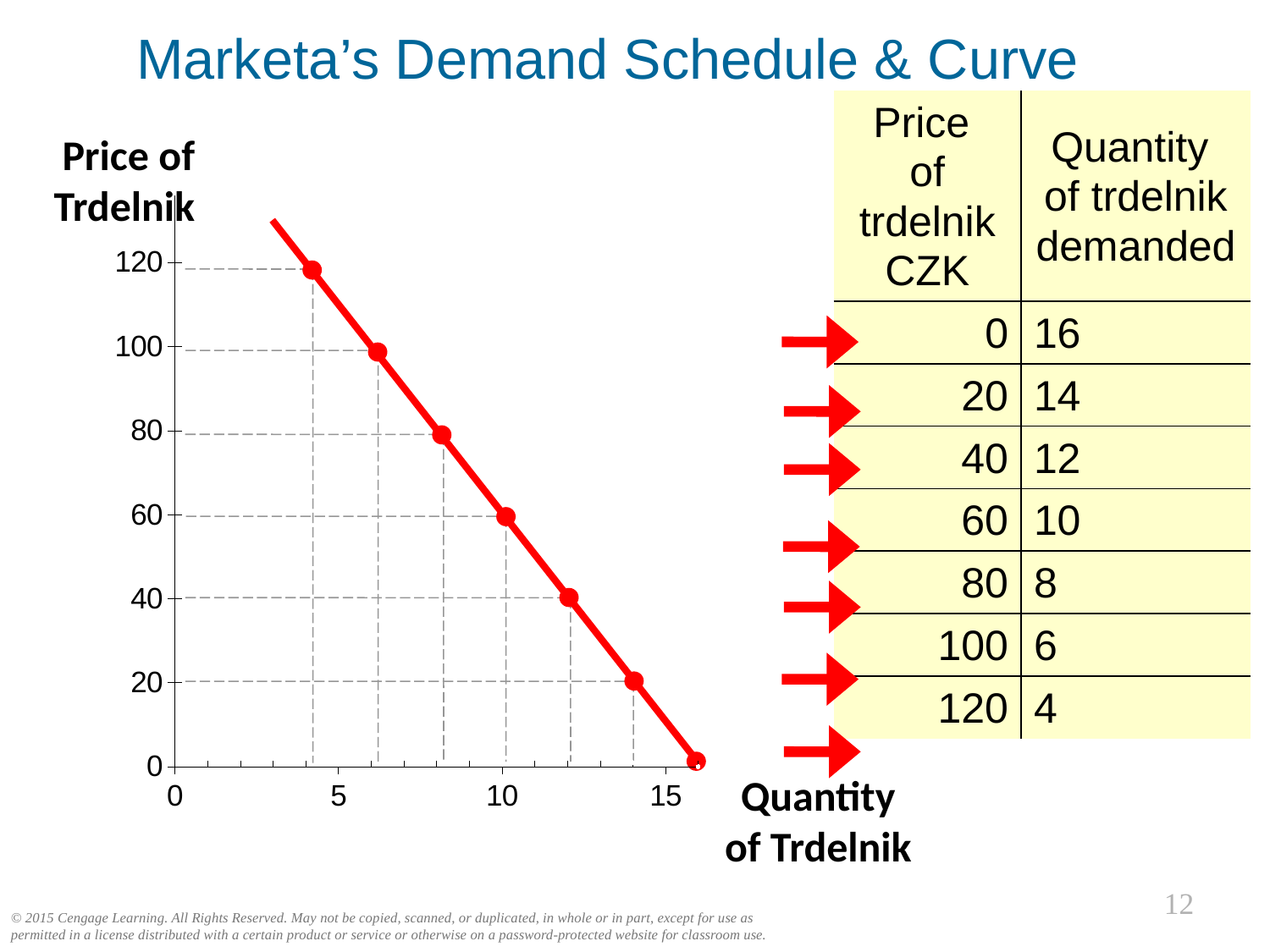
What is the label of the vertical axis of the chart? Price of Trdelnik As quantity increases along the x axis, does the price on the demand curve rise or fall? fall According to the table, what quantity of trdelnik is demanded when the price is 120 CZK? 4 At which price in the table is the quantity demanded the highest? 0 How many data points are plotted on the demand curve? 7 What is the difference between the quantity demanded at a price of 20 CZK and at a price of 100 CZK? 8 According to the table, what quantity of trdelnik is demanded when the price is 60 CZK? 10 What is the title of the slide containing the chart? Marketa's Demand Schedule & Curve According to the table, what quantity of trdelnik is demanded when the price is 0 CZK? 16 What type of chart is shown on the slide? line chart At which price in the table is the quantity demanded the lowest? 120 Is the quantity demanded larger at a price of 40 CZK or at a price of 80 CZK? 40 CZK